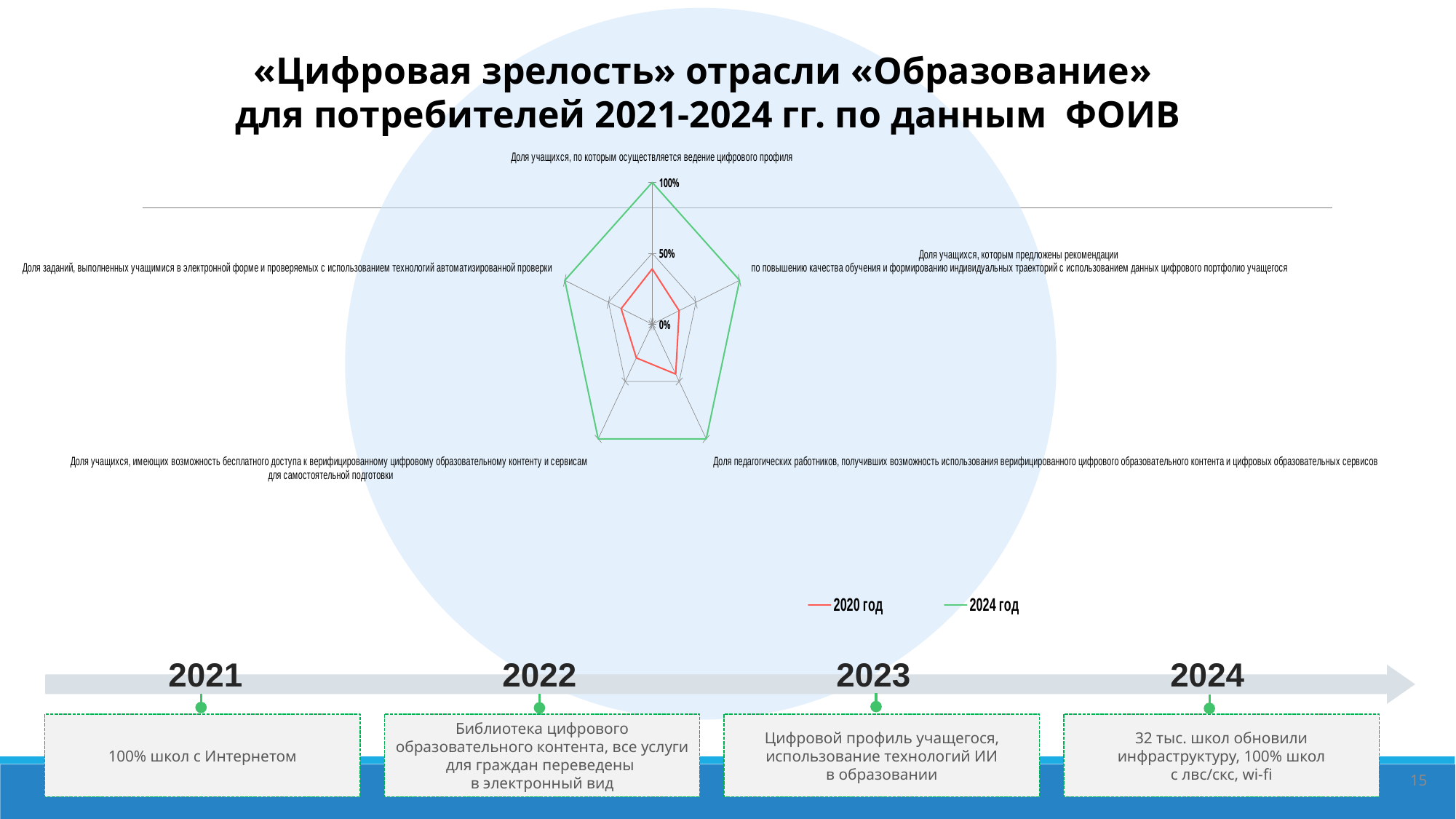
How many axes (categories) does the radar chart have? 5 Which series has the larger value for «Доля учащихся, имеющих возможность бесплатного доступа к верифицированному цифровому образовательному контенту и сервисам для самостоятельной подготовки», 2020 год or 2024 год? 2024 год Which two series are listed in the chart legend? 2020 год and 2024 год What colour is the line for the 2024 год series? green What is the maximum value shown on the radar chart's axis scale? 100% Is the 2020 год value for «Доля учащихся, по которым осуществляется ведение цифрового профиля» greater or less than 50%? less Is the 2020 год value for «Доля педагогических работников, получивших возможность использования верифицированного цифрового образовательного контента и цифровых образовательных сервисов» greater or less than 50%? less What is the value of the 2024 год series for «Доля учащихся, по которым осуществляется ведение цифрового профиля»? 100% How many series does the chart legend list? 2 What kind of chart is shown on the slide? radar chart Which series has the larger value for «Доля учащихся, которым предложены рекомендации по повышению качества обучения и формированию индивидуальных траекторий с использованием данных цифрового портфолио учащегося», 2020 год or 2024 год? 2024 год Is the 2020 год value for «Доля заданий, выполненных учащимися в электронной форме и проверяемых с использованием технологий автоматизированной проверки» greater or less than 50%? less